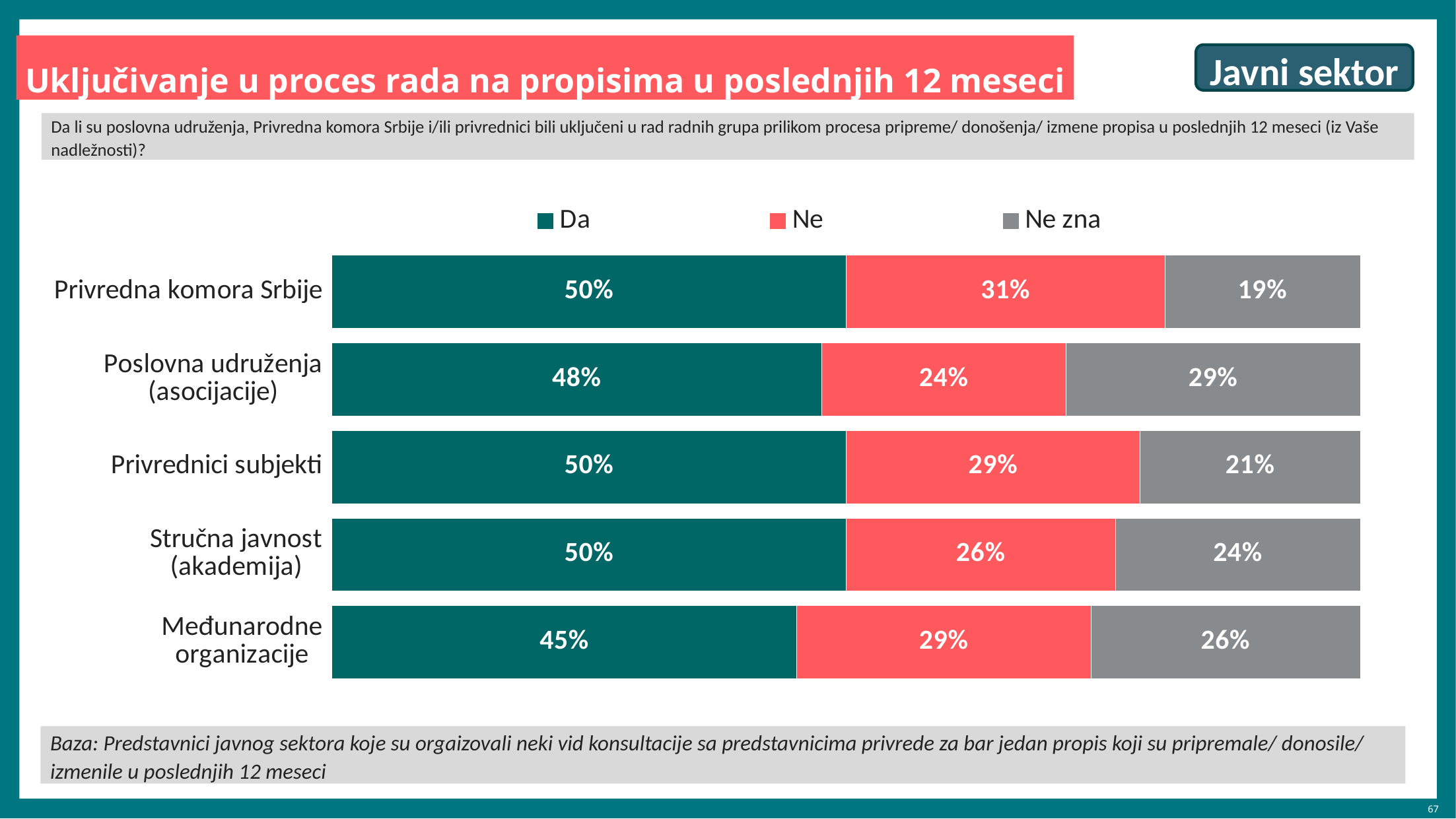
What is the "Ne zna" value for Međunarodne organizacije? 26% How many series does the legend list? 3 How many categories are shown in the chart? 5 Which category has the highest "Ne" value? Privredna komora Srbije Which has a larger "Ne" value: Privrednici subjekti or Stručna javnost (akademija)? Privrednici subjekti Which category has the lowest "Da" value? Međunarodne organizacije Which category has the highest "Ne zna" value? Poslovna udruženja (asocijacije) What is the "Ne" value for Poslovna udruženja (asocijacije)? 24% What type of chart is shown on the slide? Stacked bar chart What is the difference between the "Da" and "Ne" values for Privredna komora Srbije? 19 percentage points Which category has the lowest "Ne zna" value? Privredna komora Srbije What percentage of respondents answered "Da" for Privredna komora Srbije? 50%